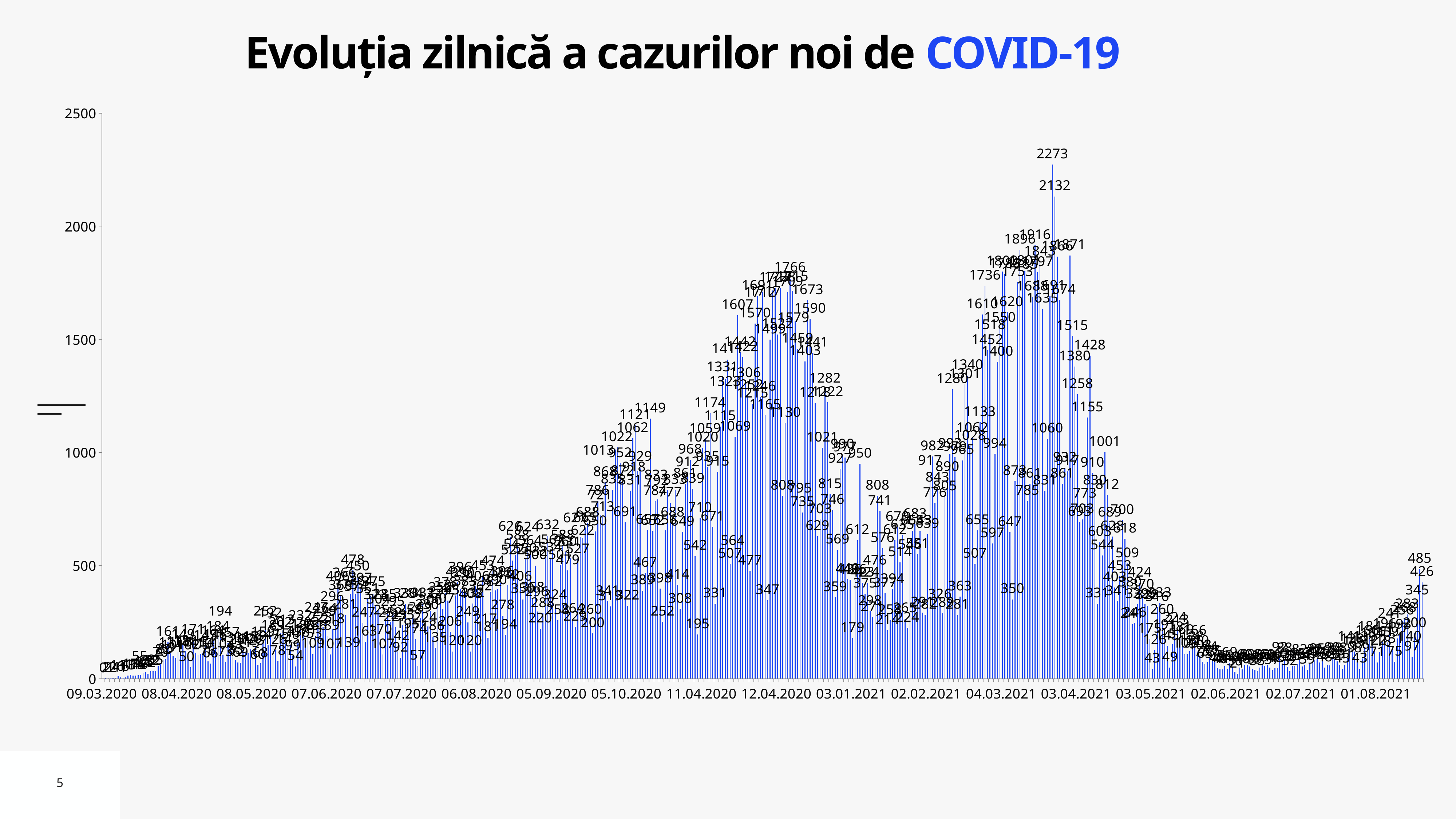
Are the bars around the 02.06.2021 tick greater or less than 500? less Which is larger: the peak of the wave near 03.04.2021 (2273) or the peak of the wave near 12.04.2020 (1766)? 2273 What is the highest daily value shown on the chart? 2273 What is the difference between the two tallest bars, labelled 2273 and 2132? 141 What is the difference between the peak near 03.04.2021 (2273) and the peak near 12.04.2020 (1766)? 507 What is the second-highest labelled value on the chart, next to the 2273 peak? 2132 What is the highest tick value shown on the y axis? 2500 What is the peak value of the wave around the 12.04.2020 tick on the x axis? 1766 What kind of chart is shown on the slide? bar chart Is the tallest bar near 03.04.2021 greater or less than 2000? greater Do the values rise or fall between the 03.04.2021 tick and the 02.06.2021 tick? fall What is the title of the chart? Evoluția zilnică a cazurilor noi de COVID-19